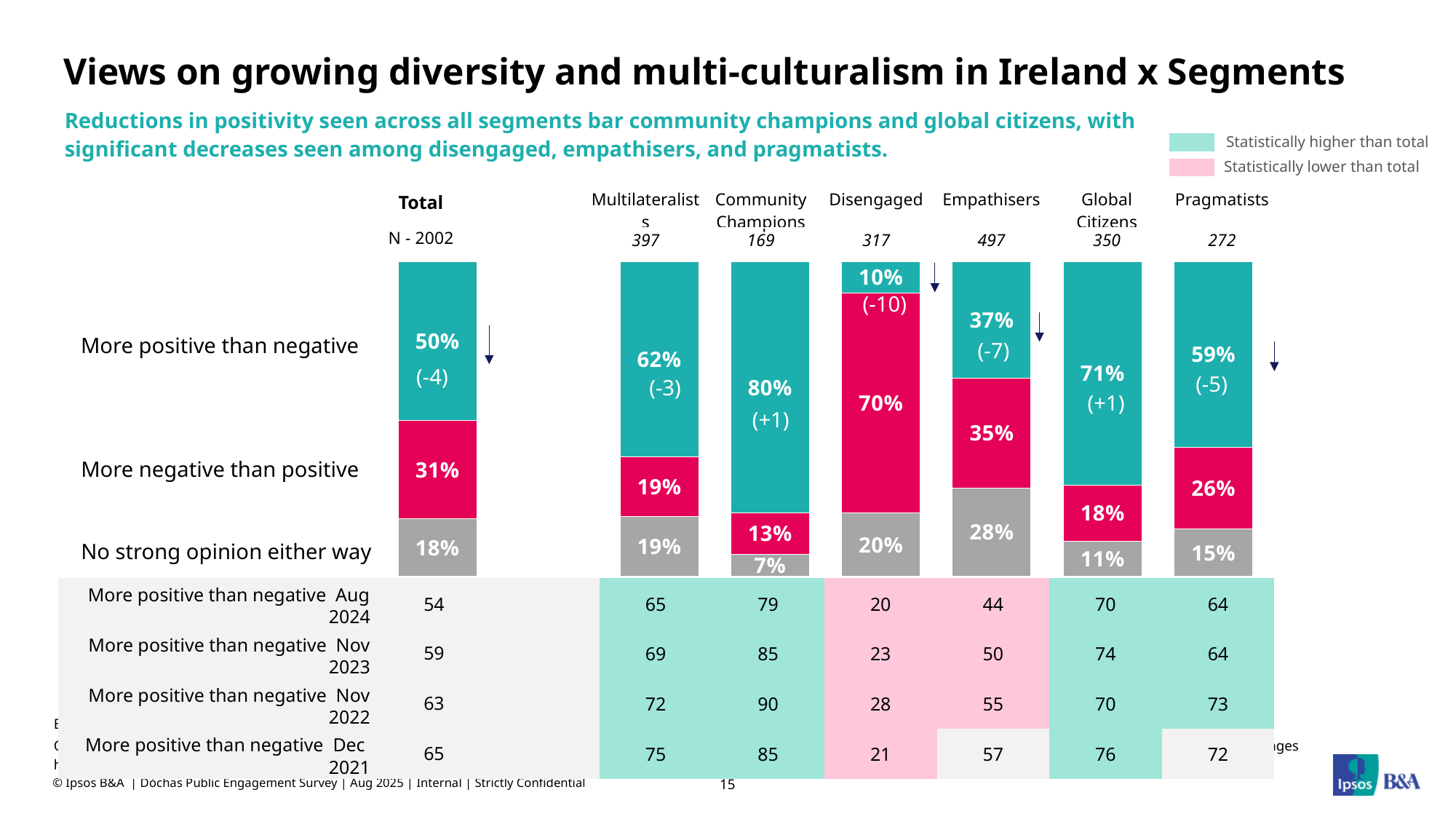
What was the 'More positive than negative' value for Empathisers in Nov 2022, according to the table below the chart? 55 What percentage of Disengaged respondents are 'More negative than positive'? 70% Which segment has the highest share of 'More positive than negative'? Community Champions What is the difference between the 'More positive than negative' shares of Global Citizens and Pragmatists? 12 percentage points How many response categories are stacked in each bar? 3 What percentage of the Total group is 'More positive than negative'? 50% Which segment has the lowest share of 'More positive than negative'? Disengaged What percentage of Community Champions have 'No strong opinion either way'? 7% What kind of chart is shown on the slide? Stacked bar chart What is the change shown in brackets for the Disengaged 'More positive than negative' value? (-10) Which is larger: the 'More negative than positive' share for Multilateralists or for Pragmatists? Pragmatists How many segment bars are shown in the chart, including Total? 7